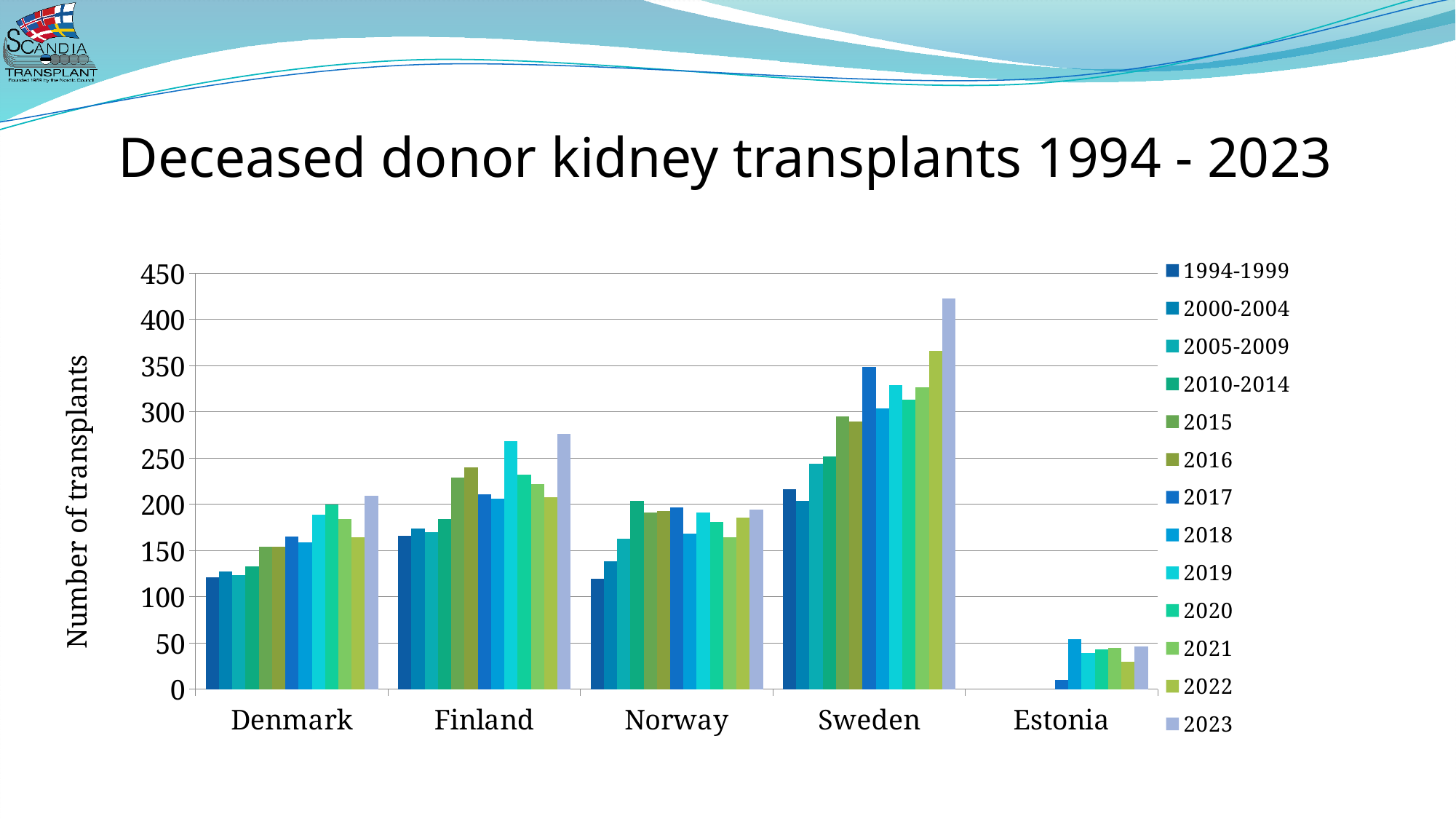
How many series does the legend list? 13 How many countries are shown on the x axis? 5 What is the label on the vertical axis? Number of transplants Which country has the highest bar for 2023? Sweden For Sweden, which is larger, the 2017 value or the 2018 value? 2017 Is the value for Estonia in 2022 greater or less than 50? less Which is larger, the 2019 value for Finland or the 2019 value for Norway? Finland What kind of chart is shown on the slide? bar chart Which country has the lowest bar for 2023? Estonia Is the value for Finland in 2023 greater or less than 250? greater Is the value for Norway in 1994-1999 greater or less than 150? less